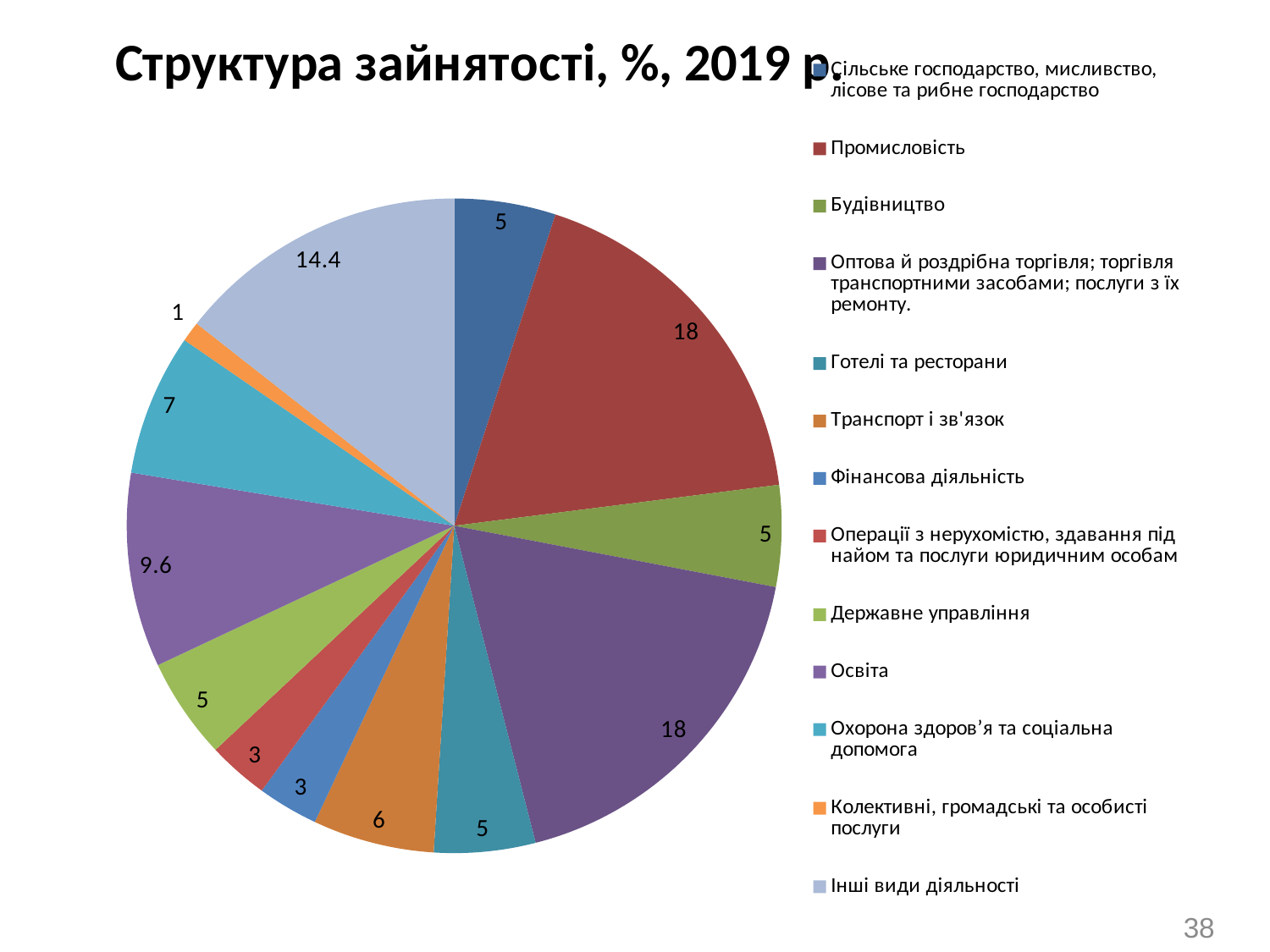
Which is larger, the value for Охорона здоров'я та соціальна допомога or the value for Транспорт і зв'язок? Охорона здоров'я та соціальна допомога What is the title of the chart? Структура зайнятості, %, 2019 р. What is the value for Охорона здоров'я та соціальна допомога? 7 How many slices does the pie chart have? 13 Which category has the smallest slice? Колективні, громадські та особисті послуги What is the value for Транспорт і зв'язок? 6 How many entries does the legend list? 13 What is the value for Промисловість? 18 What is the value for Інші види діяльності? 14.4 What is the difference between the values for Інші види діяльності and Освіта? 4.8 What is the value for Освіта? 9.6 What type of chart is shown on the slide? pie chart